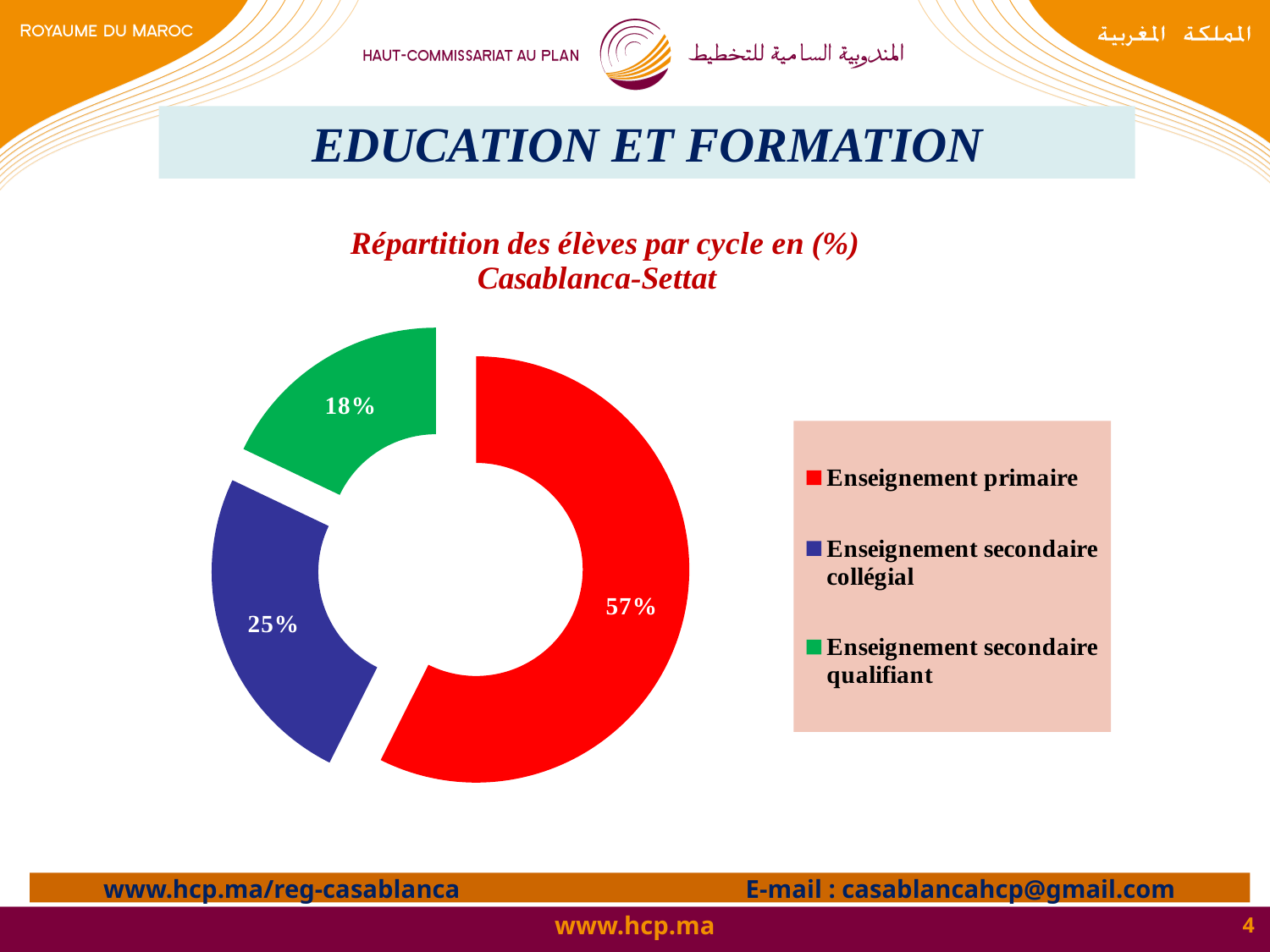
What kind of chart is shown on the slide? Pie chart (doughnut) What is the title of the chart? Répartition des élèves par cycle en (%) Casablanca-Settat Which cycle has the smallest share of students? Enseignement secondaire qualifiant What share of students is in Enseignement secondaire collégial? 25% Which is larger: the share for Enseignement secondaire collégial or for Enseignement secondaire qualifiant? Enseignement secondaire collégial What is the difference in percentage points between Enseignement primaire and Enseignement secondaire collégial? 32 Which cycle has the largest share of students? Enseignement primaire What is the difference in percentage points between Enseignement secondaire collégial and Enseignement secondaire qualifiant? 7 What share of students is in Enseignement secondaire qualifiant? 18% How many categories does the chart show? 3 What share of students is in Enseignement primaire? 57% What colour represents Enseignement secondaire qualifiant in the chart? Green